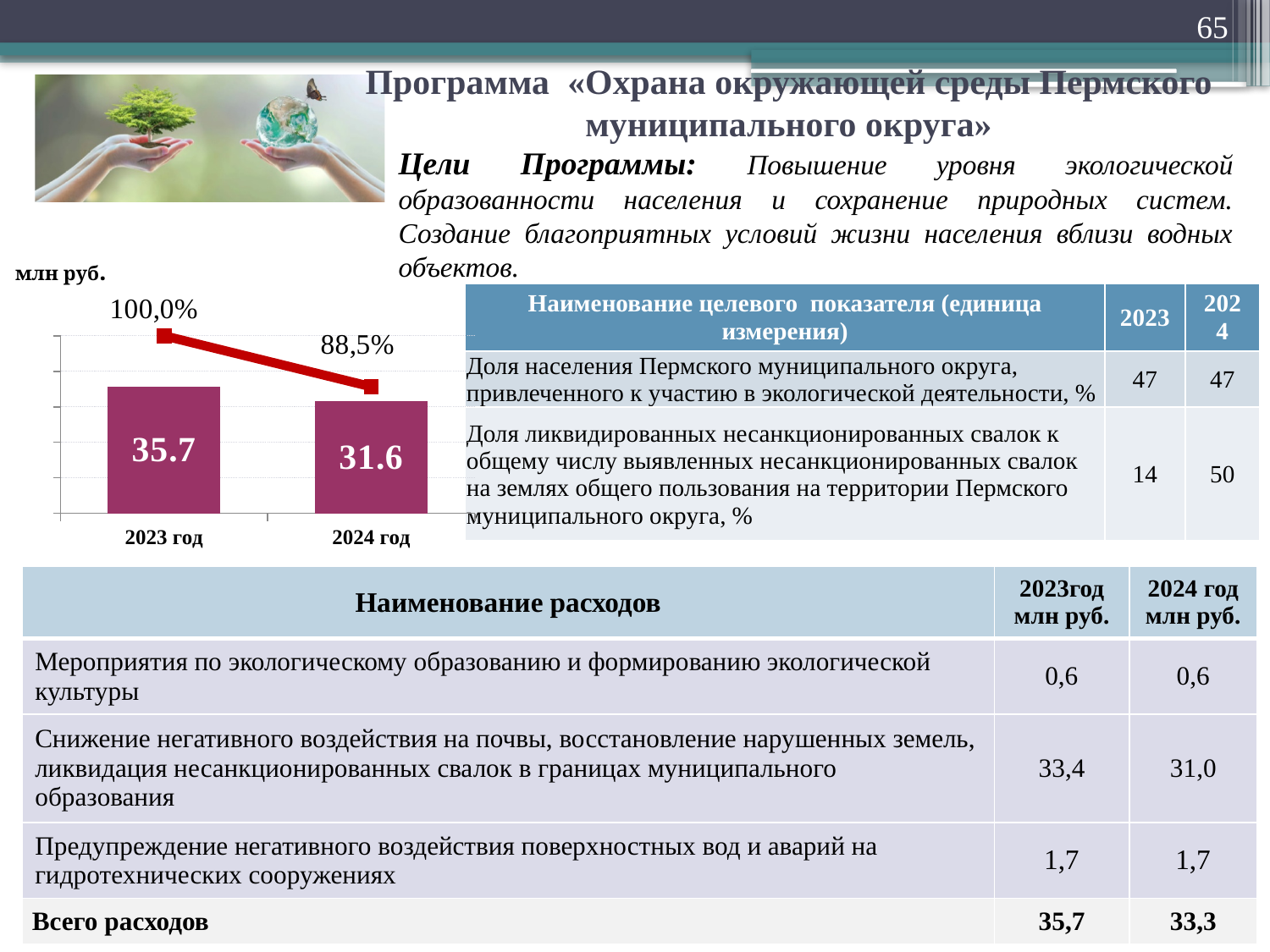
What is the difference between the bar values for 2023 год and 2024 год? 4.1 Do the bar values rise or fall from 2023 год to 2024 год? fall What kind of chart is shown on the slide? combination bar and line chart How many bars are shown in the chart? 2 Which bar is larger, 2023 год or 2024 год? 2023 год Which year has the highest bar in the chart? 2023 год What is the value for 2024 год in the bar chart? 31.6 What unit is indicated above the chart? млн руб. Which year has the lowest bar in the chart? 2024 год What percentage label is shown on the line above the 2024 год bar? 88,5% What percentage label is shown on the line above the 2023 год bar? 100,0% What is the value for 2023 год in the bar chart? 35.7